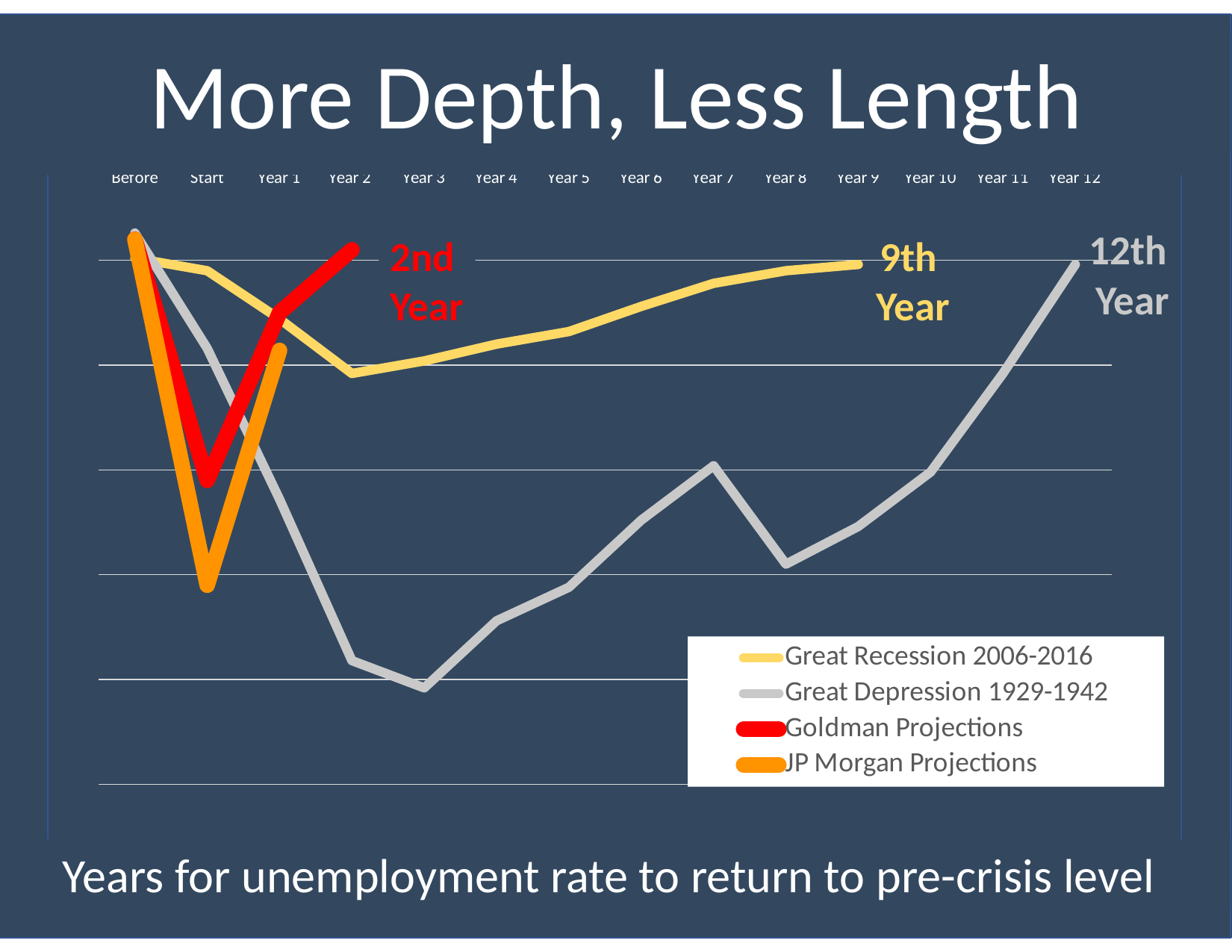
Does the Great Recession 2006-2016 line rise or fall from Year 2 to Year 9? Rise According to the annotation, in which year does the Great Depression 1929-1942 line return to the pre-crisis level? 12th Year What kind of chart is shown on the slide? Line chart Which series drops to the lowest point on the chart? Great Depression 1929-1942 According to the annotation, in which year does the Great Recession 2006-2016 line return to the pre-crisis level? 9th Year What is the last category on the x axis? Year 12 Which series takes the longest to return to the pre-crisis level? Great Depression 1929-1942 Which series is drawn in grey? Great Depression 1929-1942 How many series does the legend list? 4 How many categories are shown along the x axis? 14 What is the first category on the x axis? Before According to the annotation, in which year does the Goldman Projections line return to the pre-crisis level? 2nd Year